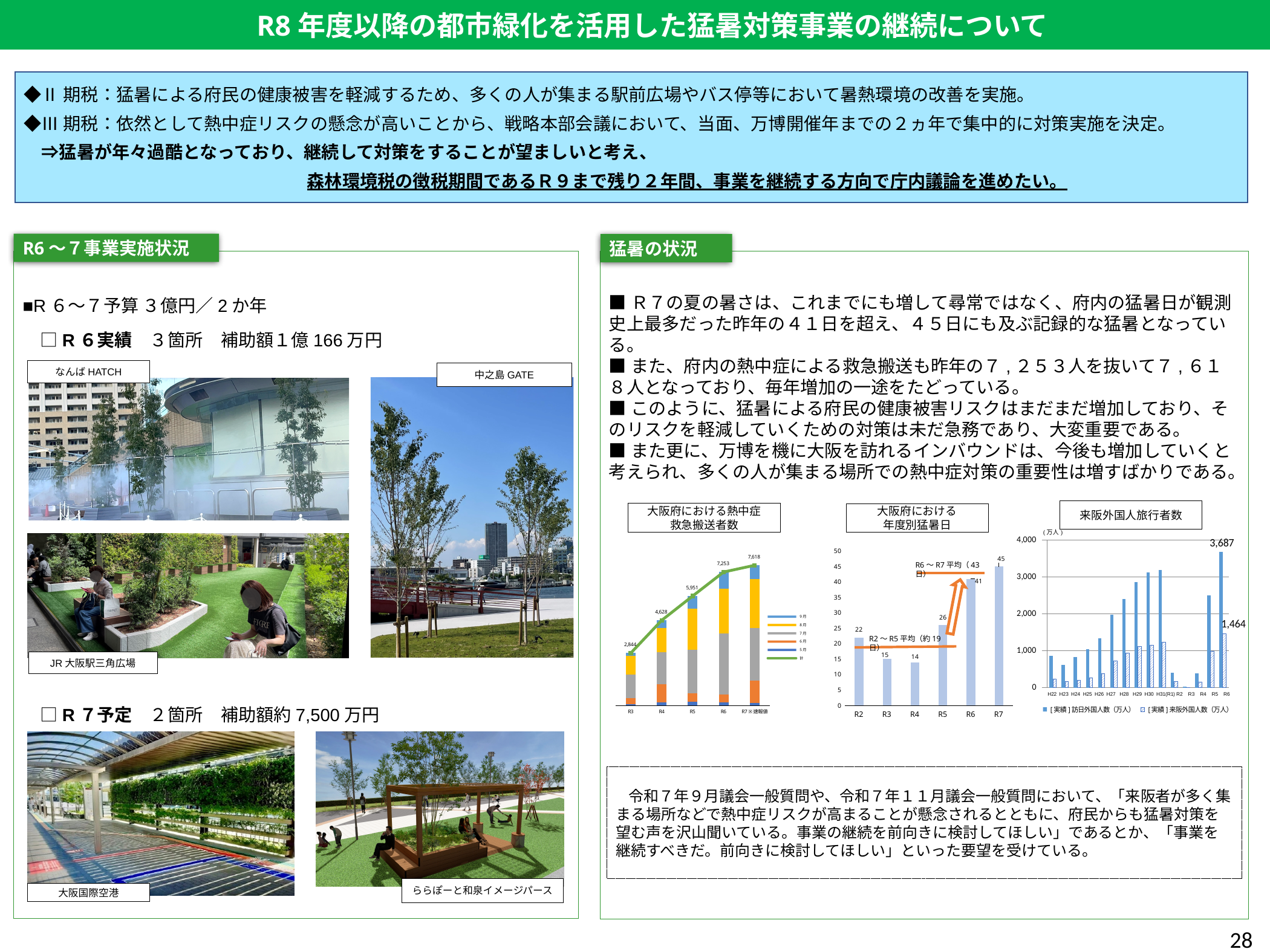
In the chart titled 大阪府における熱中症救急搬送者数, what is the difference between the totals for R7※速報値 and R6? 365 In the chart titled 来阪外国人旅行者数, is the value for 訪日外国人数 in R2 greater or less than 1,000? less In the chart titled 大阪府における年度別猛暑日, what is the difference between R6 and R5? 15 In the chart titled 大阪府における熱中症救急搬送者数, how many entries does the legend list? 6 In the chart titled 大阪府における熱中症救急搬送者数, do the totals rise or fall from R3 to R7? rise In the chart titled 大阪府における年度別猛暑日, how many years are plotted? 6 In the chart titled 大阪府における熱中症救急搬送者数, what is the total value shown for R3? 2,844 In the chart titled 大阪府における年度別猛暑日, what is the value for R7? 45 In the chart titled 大阪府における年度別猛暑日, which year has the lowest value? R4 In the chart titled 大阪府における熱中症救急搬送者数, what is the total value shown for R6? 7,253 In the chart titled 来阪外国人旅行者数, what is the value labelled for 訪日外国人数 in R6? 3,687 What kind of chart is the one titled 来阪外国人旅行者数? bar chart